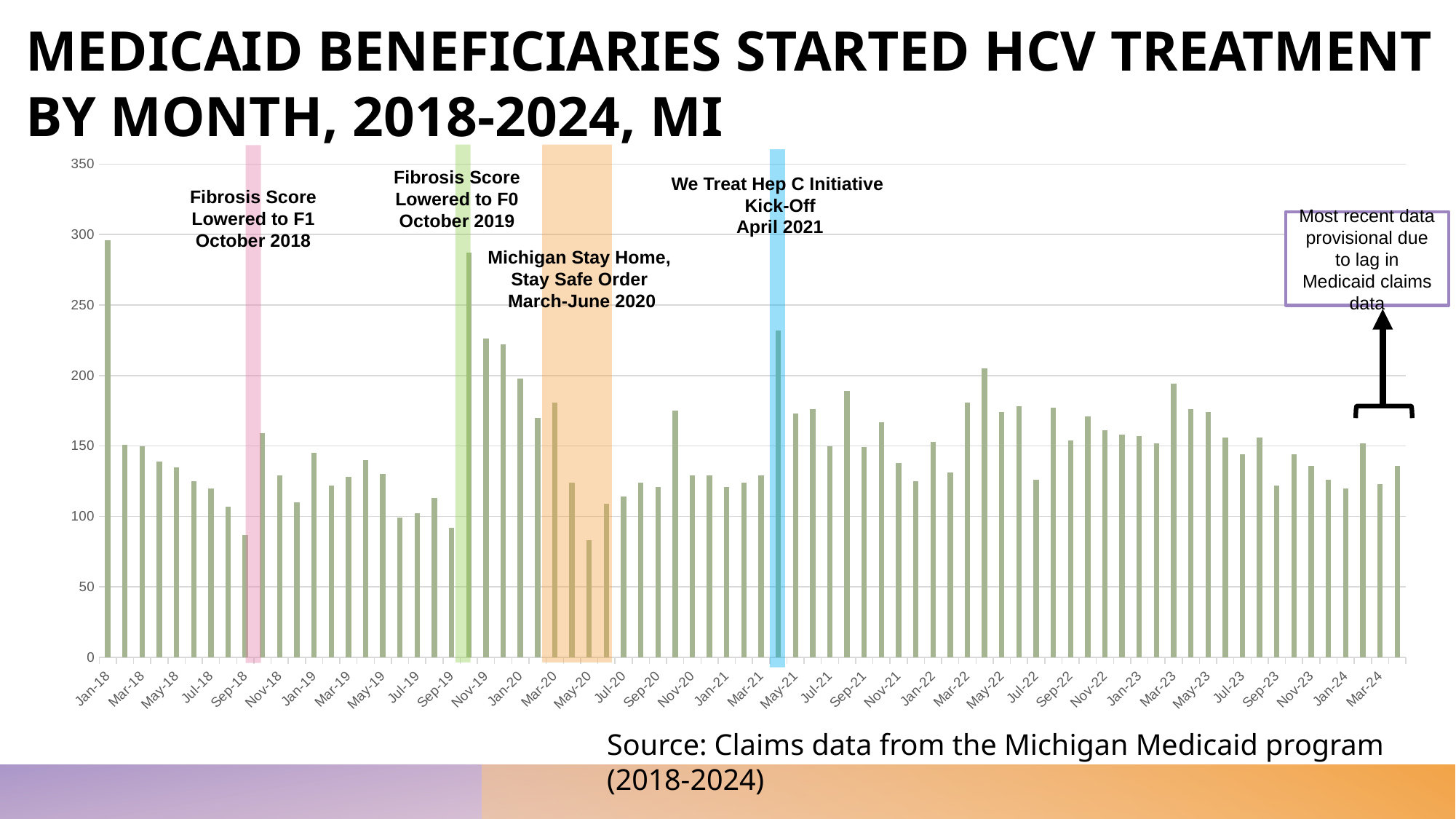
Is the value for Jan-18 greater or less than 250? greater What is the title of the chart? Medicaid Beneficiaries Started HCV Treatment by Month, 2018-2024, MI Is the value for Apr-21 greater or less than 200? greater Is the value for Mar-23 greater or less than 150? greater What kind of chart is shown on the slide? bar chart Which is larger, the value for Jan-18 or the value for Mar-18? Jan-18 Do the values rise or fall from Jan-18 to Sep-18? fall According to the annotation, in which month and year was the We Treat Hep C Initiative kicked off? April 2021